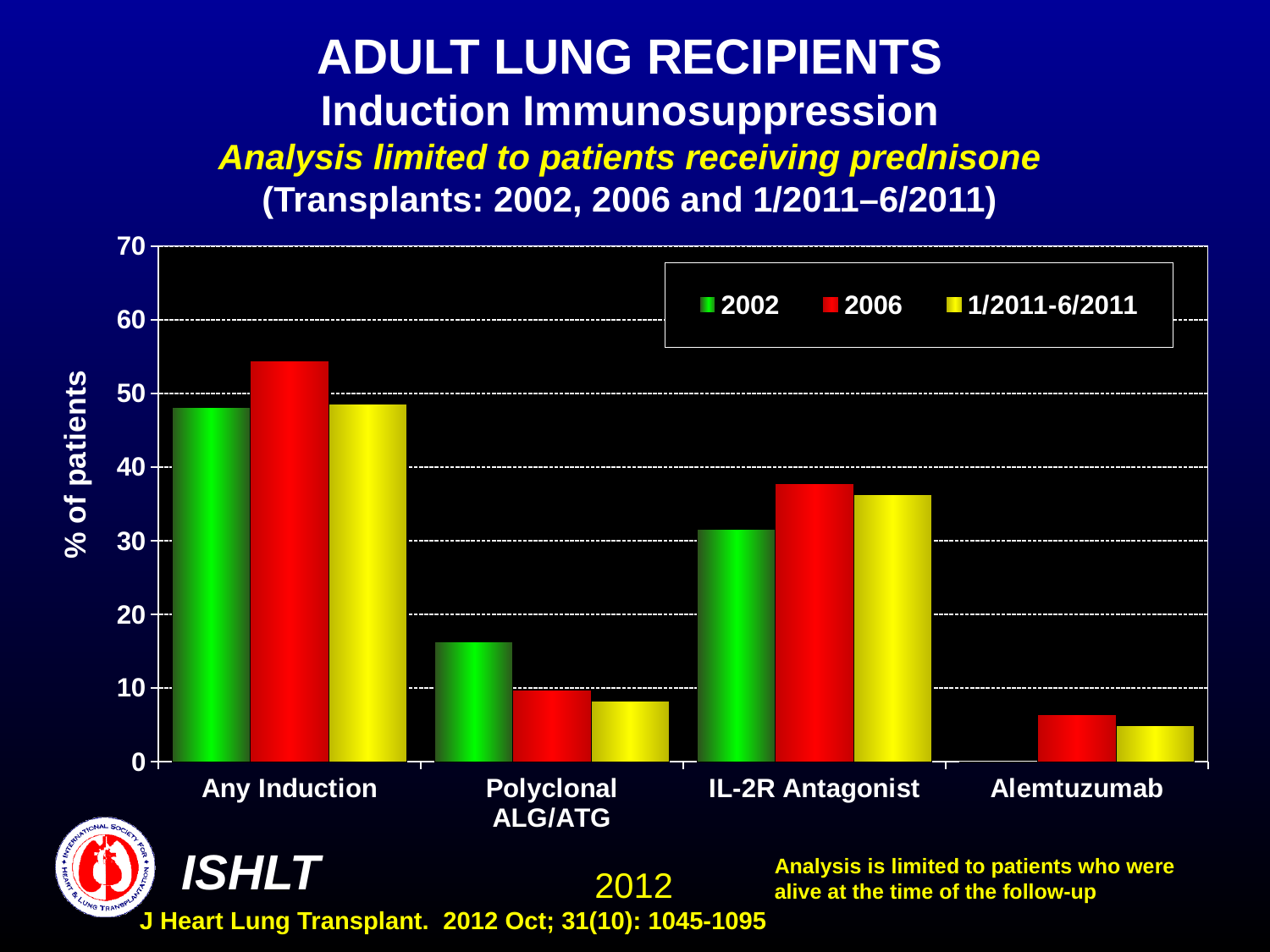
How many induction categories are shown on the x axis? 4 Within the Any Induction category, which series has the tallest bar? 2006 Is the 2006 value for IL-2R Antagonist greater or less than 40? less What kind of chart is shown on the slide? bar chart How many series does the legend list? 3 Which category has the highest value for the 2006 series? Any Induction Is the 2006 value for Any Induction greater or less than 50? greater Is the 2006 value for Alemtuzumab greater or less than 10? less What is the label on the y axis? % of patients For Polyclonal ALG/ATG, which is larger: the 2002 value or the 2006 value? 2002 Which category has the lowest value for the 2006 series? Alemtuzumab